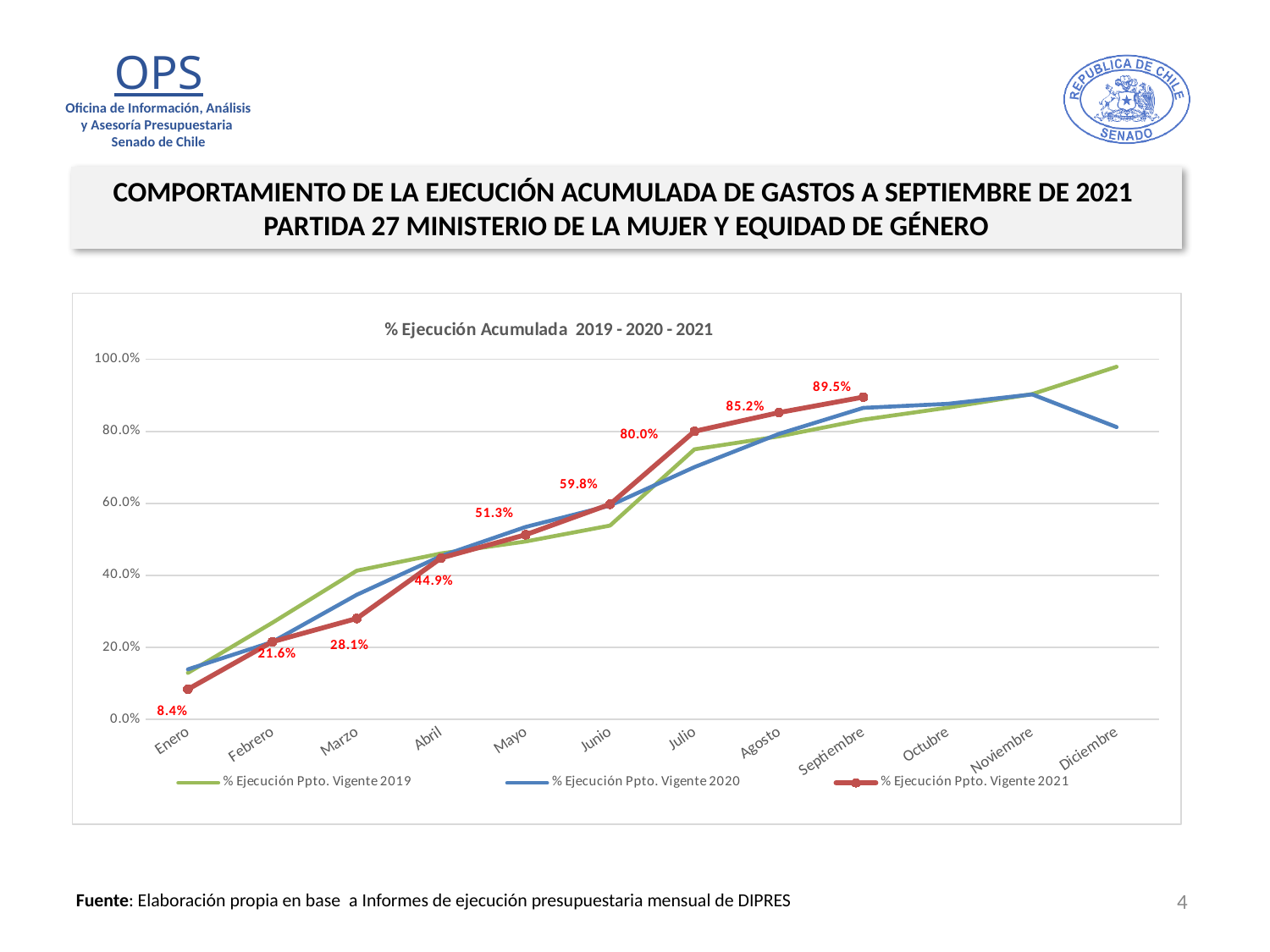
How many months are shown on the x axis? 12 What is the value of % Ejecución Ppto. Vigente 2021 for Abril? 44.9% What is the value of % Ejecución Ppto. Vigente 2021 for Septiembre? 89.5% Does the % Ejecución Ppto. Vigente 2021 series rise or fall from Enero to Septiembre? Rise What kind of chart is shown on the slide? Line chart What is the difference between the 2021 values for Septiembre and Agosto? 4.3 percentage points What is the value of % Ejecución Ppto. Vigente 2021 for Enero? 8.4% How many series does the legend list? 3 Is the value for % Ejecución Ppto. Vigente 2019 in Diciembre greater or less than 80.0%? greater What is the difference between the 2021 values for Julio and Junio? 20.2 percentage points Which month has the highest labeled value for % Ejecución Ppto. Vigente 2021? Septiembre Which month has the lowest labeled value for % Ejecución Ppto. Vigente 2021? Enero